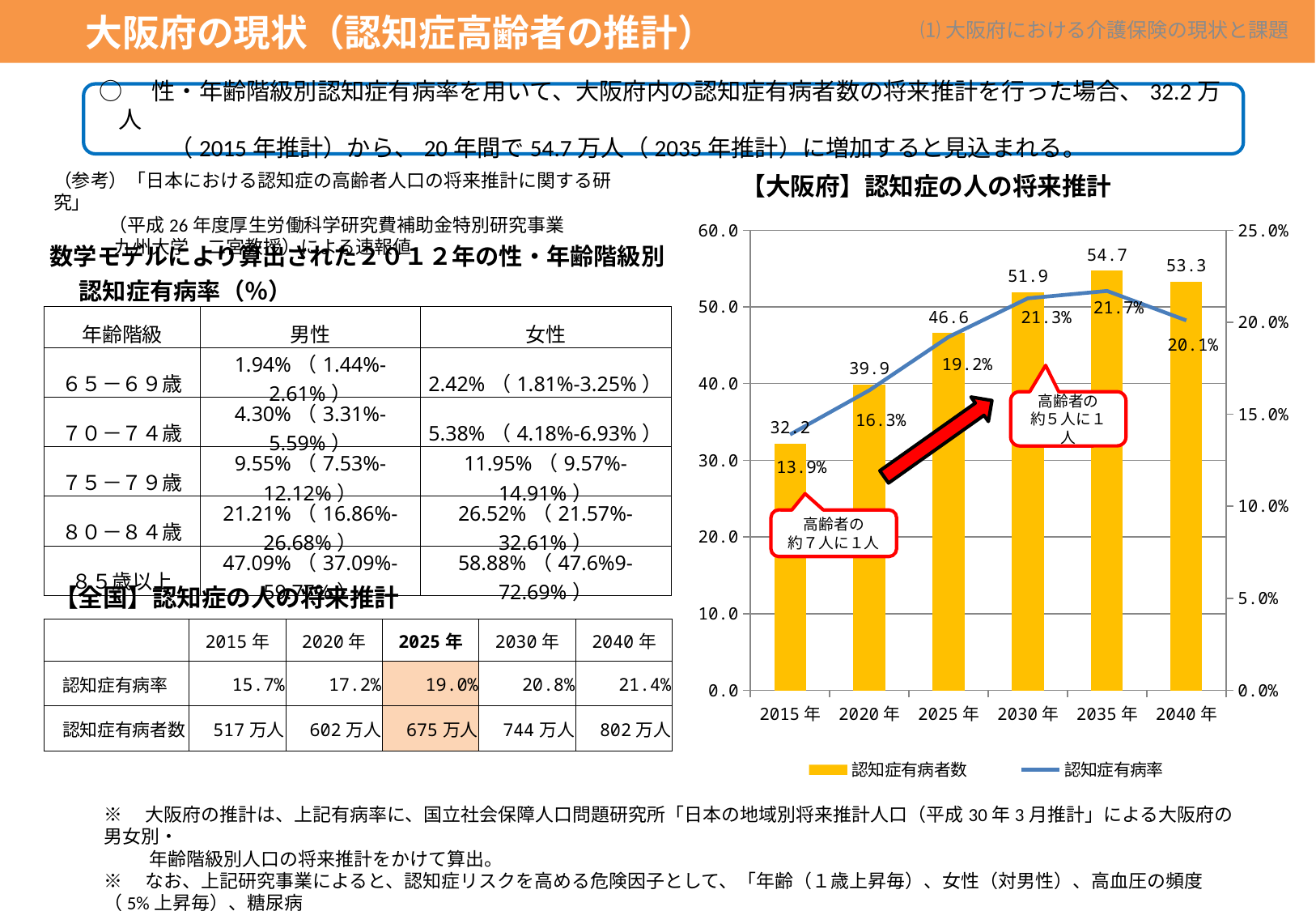
How many series does the legend of the chart 【大阪府】認知症の人の将来推計 list? 2 In the chart 【大阪府】認知症の人の将来推計, is the 認知症有病者数 for 2020年 greater or less than 40.0? less How many years are shown on the x axis of the chart 【大阪府】認知症の人の将来推計? 6 In the chart 【大阪府】認知症の人の将来推計, what is the difference in 認知症有病者数 between 2035年 and 2015年? 22.5 In the chart 【大阪府】認知症の人の将来推計, does the 認知症有病者数 rise or fall from 2015年 to 2035年? rise In the chart 【大阪府】認知症の人の将来推計, what is the value of 認知症有病者数 for 2015年? 32.2 In the chart 【大阪府】認知症の人の将来推計, which year has the lowest 認知症有病率? 2015年 In the chart 【大阪府】認知症の人の将来推計, which is larger, the 認知症有病者数 for 2025年 or for 2040年? 2040年 In the chart 【大阪府】認知症の人の将来推計, which year has the highest 認知症有病者数? 2035年 What kind of chart is 【大阪府】認知症の人の将来推計? Combined bar and line chart In the chart 【大阪府】認知症の人の将来推計, what is the value of 認知症有病者数 for 2040年? 53.3 In the chart 【大阪府】認知症の人の将来推計, what is the 認知症有病率 for 2030年? 21.3%